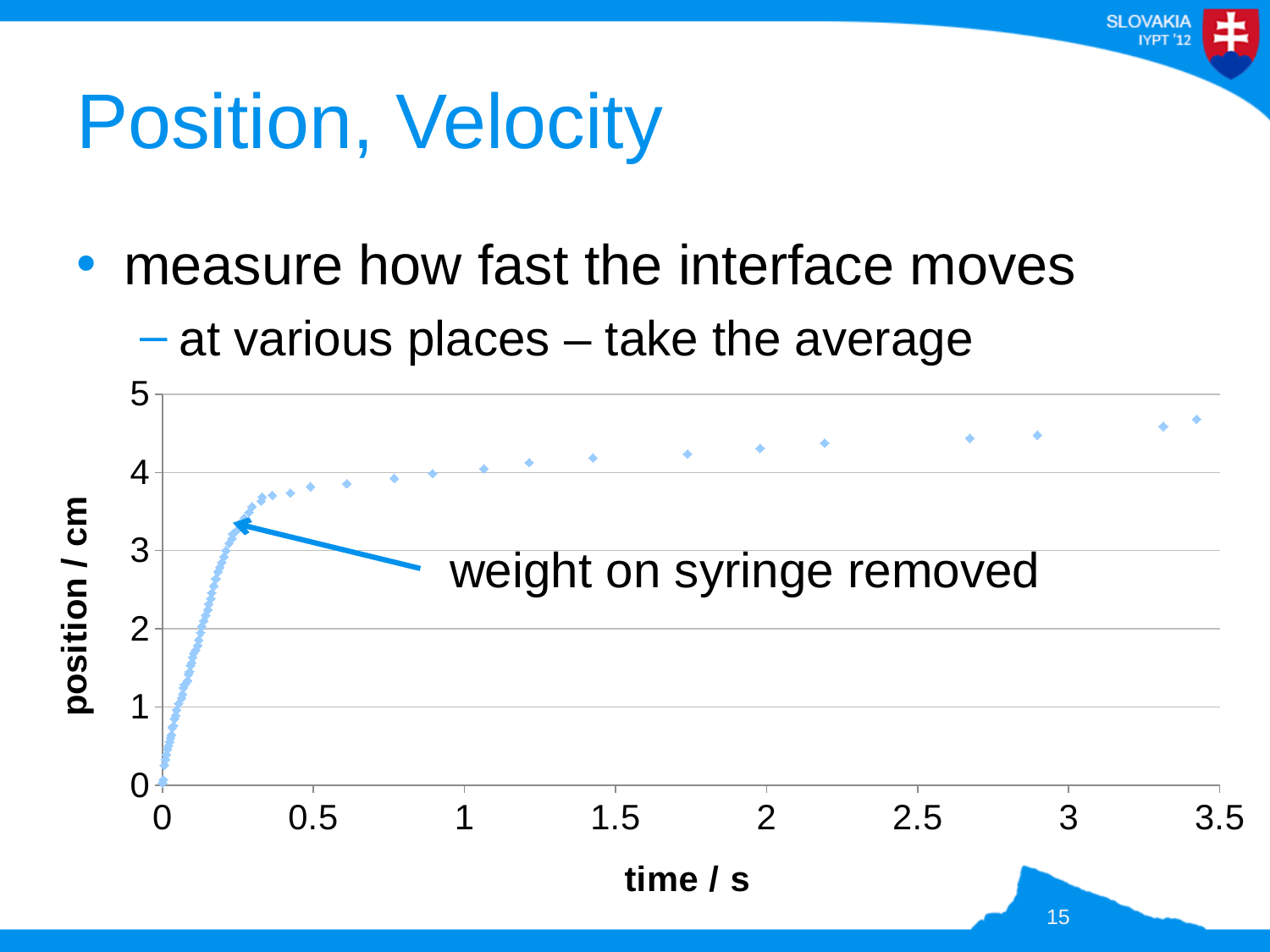
Do the plotted position values rise or fall as time increases? rise What is the highest value shown on the vertical axis of the chart? 5 What is the label of the horizontal axis of the chart? time / s Is the position value at time 2 s greater or less than 5? less What is the label of the vertical axis of the chart? position / cm Is the position value at time 0.1 s greater or less than 3? less Which is larger, the position at time 3 s or the position at time 1 s? position at time 3 s Is the position value at time 1 s greater or less than 3? greater What kind of chart is shown on the slide? scatter chart